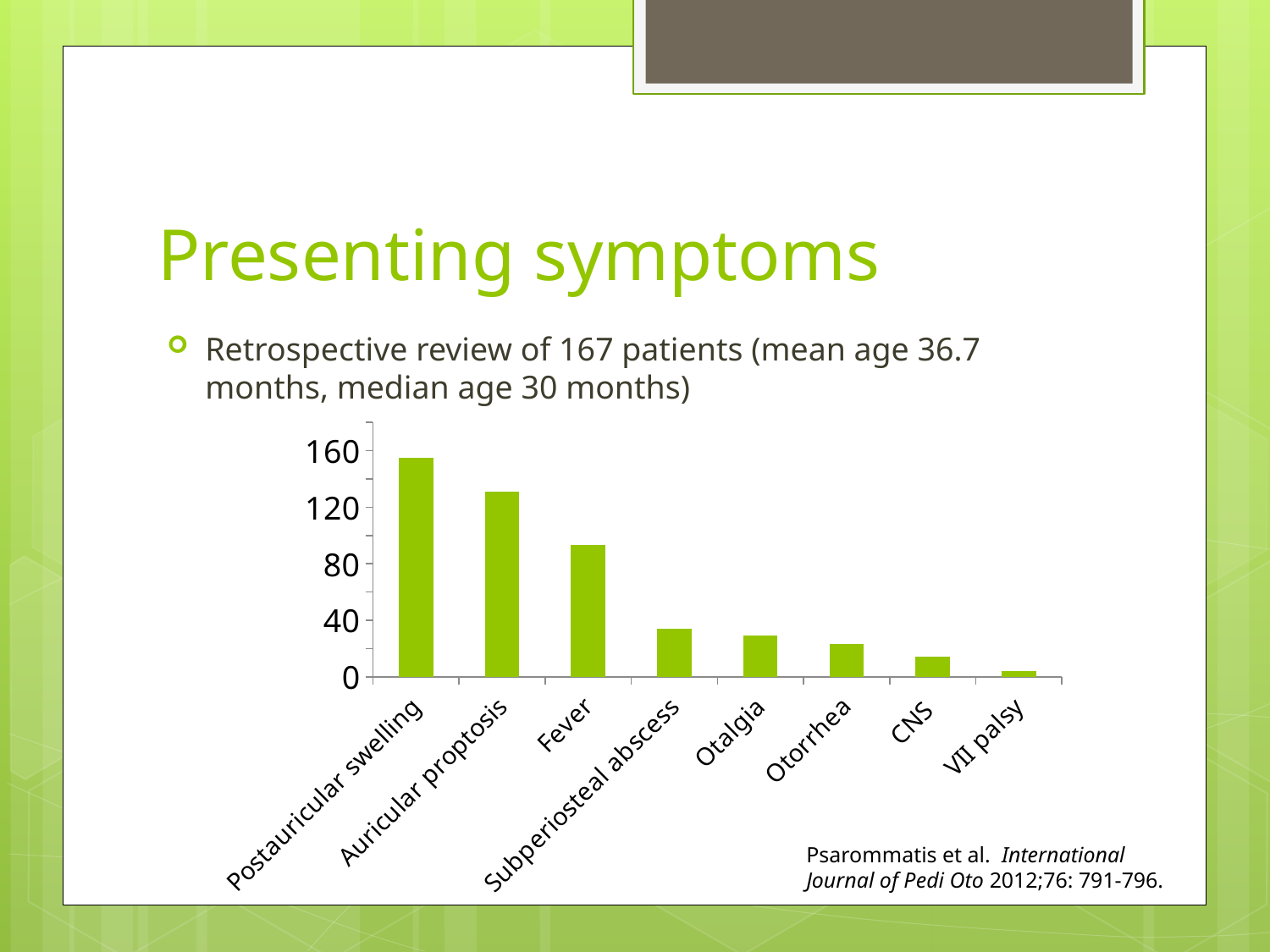
What is the highest tick value shown on the vertical axis of the chart? 160 Is the value for CNS greater or less than 40? less Do the bar values rise or fall moving from left to right along the x axis? fall Which is larger, the value for Fever or the value for Subperiosteal abscess? Fever Is the value for Subperiosteal abscess greater or less than 40? less Which presenting symptom has the highest bar on the chart? Postauricular swelling How many presenting symptoms (categories) are plotted on the chart? 8 Is the value for Postauricular swelling greater or less than 120? greater Which presenting symptom has the lowest bar on the chart? VII palsy What kind of chart is shown on the slide? bar chart Which is larger, the value for Auricular proptosis or the value for Fever? Auricular proptosis